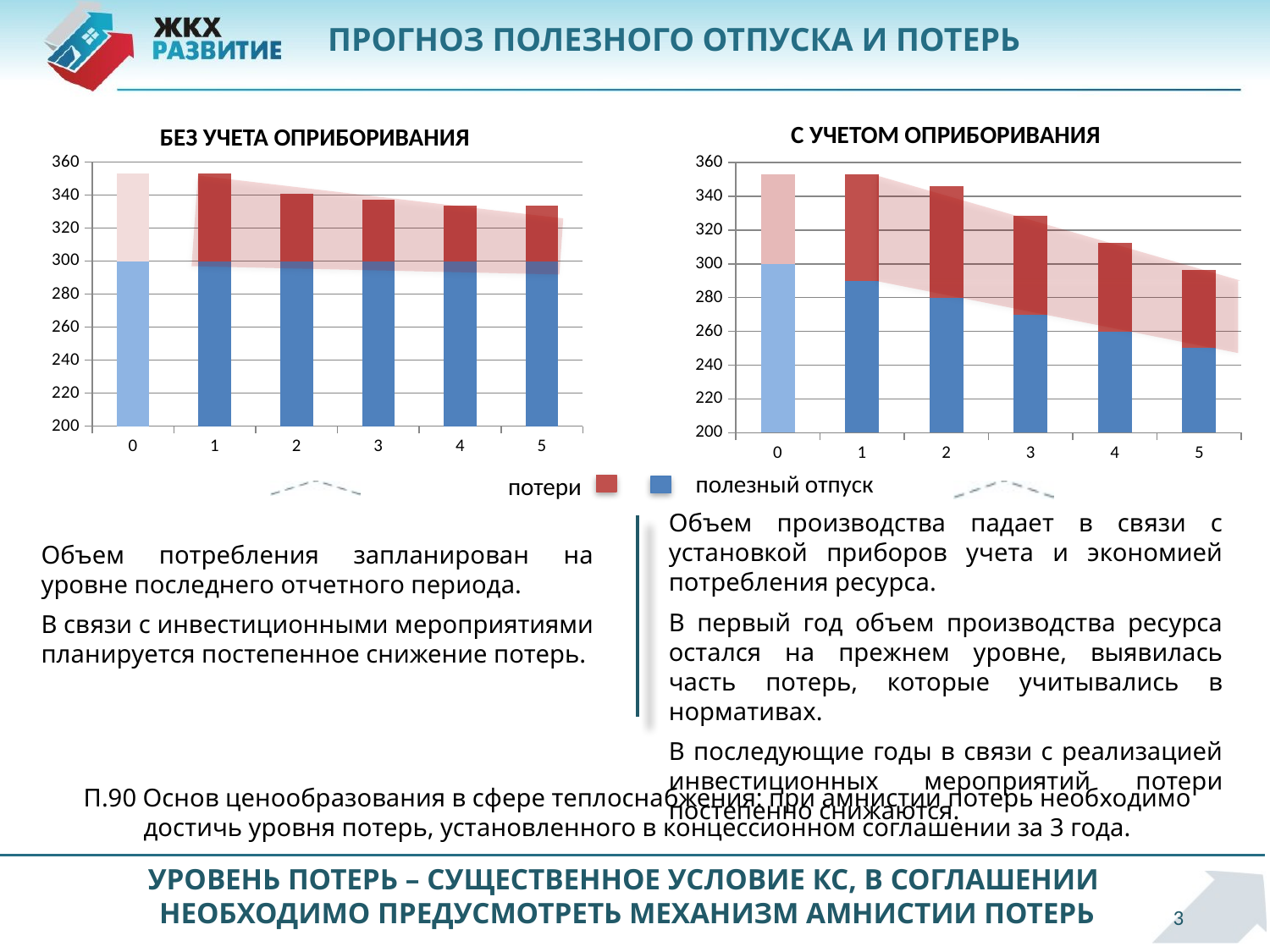
What are the two series named in the legend below the charts? потери and полезный отпуск In the chart titled 'С УЧЕТОМ ОПРИБОРИВАНИЯ', which is larger: the 'полезный отпуск' value for category 1 or for category 5? Category 1 For category 5, which chart shows the larger 'полезный отпуск' value: 'БЕЗ УЧЕТА ОПРИБОРИВАНИЯ' or 'С УЧЕТОМ ОПРИБОРИВАНИЯ'? БЕЗ УЧЕТА ОПРИБОРИВАНИЯ In the chart titled 'С УЧЕТОМ ОПРИБОРИВАНИЯ', which category has the lowest total bar height? 5 What kind of chart is the chart titled 'БЕЗ УЧЕТА ОПРИБОРИВАНИЯ'? Stacked bar chart In the chart titled 'С УЧЕТОМ ОПРИБОРИВАНИЯ', do the 'полезный отпуск' values rise or fall from category 0 to category 5? Fall How many series does the shared legend below the two charts list? 2 In the chart titled 'С УЧЕТОМ ОПРИБОРИВАНИЯ', is the 'полезный отпуск' value for category 5 greater or less than 260? less In the chart titled 'БЕЗ УЧЕТА ОПРИБОРИВАНИЯ', do the total bar heights rise or fall from category 1 to category 5? Fall In the chart titled 'С УЧЕТОМ ОПРИБОРИВАНИЯ', is the total bar height for category 1 greater or less than 340? greater How many categories are shown on the x axis of the chart titled 'С УЧЕТОМ ОПРИБОРИВАНИЯ'? 6 In the chart titled 'БЕЗ УЧЕТА ОПРИБОРИВАНИЯ', is the total bar height for category 5 greater or less than 320? greater